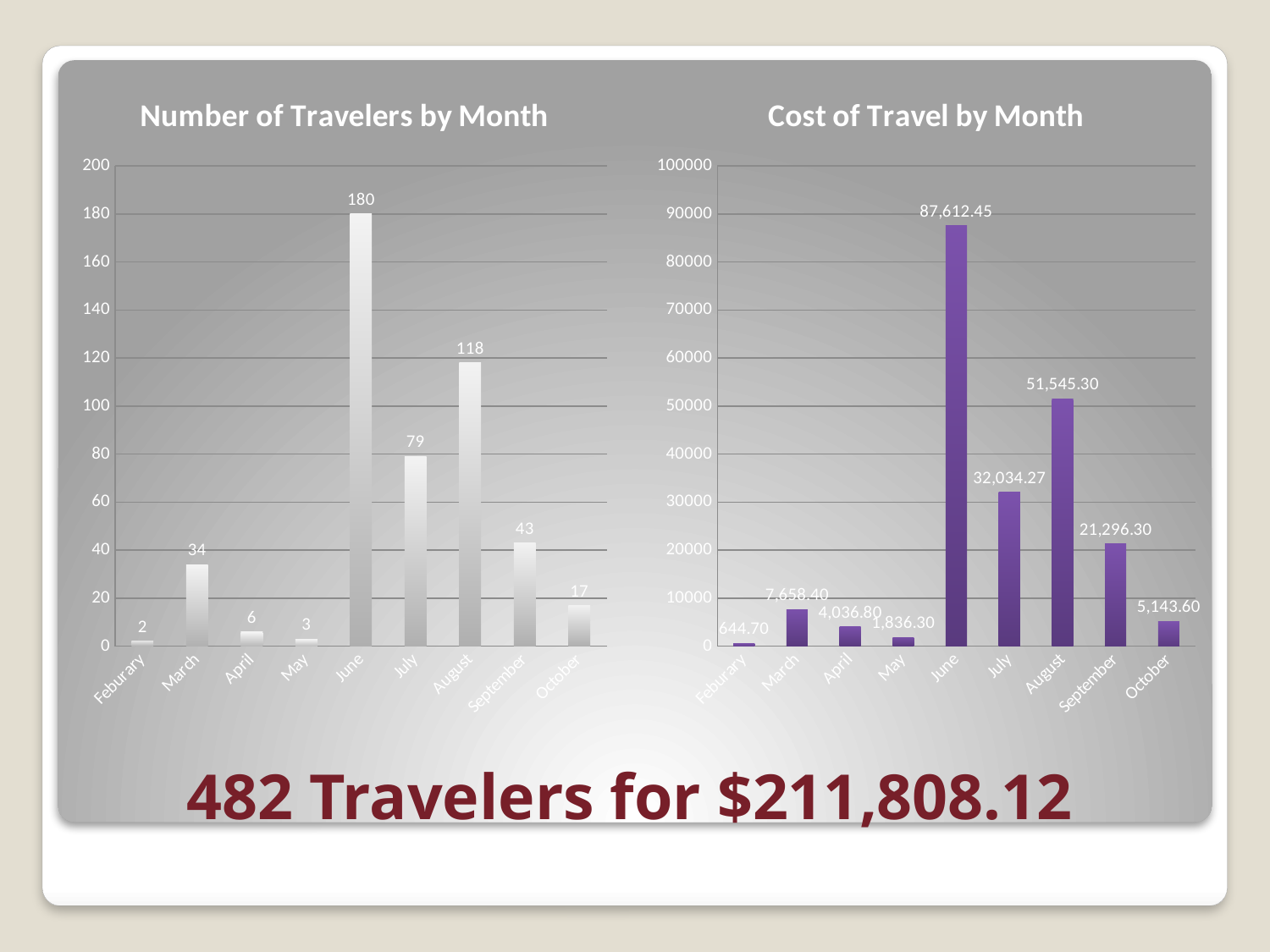
In the 'Number of Travelers by Month' chart, what is the value for September? 43 In the 'Number of Travelers by Month' chart, what is the difference between the values for June and August? 62 In the 'Cost of Travel by Month' chart, is the value for August greater or less than 50000? greater In the 'Cost of Travel by Month' chart, what is the value for July? 32,034.27 How many months are shown on the x axis of the 'Number of Travelers by Month' chart? 9 In the 'Cost of Travel by Month' chart, what is the value for October? 5,143.60 In the 'Number of Travelers by Month' chart, do the values rise or fall from June to September? fall In the 'Number of Travelers by Month' chart, what is the value for June? 180 In the 'Number of Travelers by Month' chart, which month has the lowest value? Feburary In the 'Cost of Travel by Month' chart, which month has the highest value? June What kind of chart is the 'Cost of Travel by Month' chart? bar chart In the 'Cost of Travel by Month' chart, which is larger, the value for March or the value for April? March